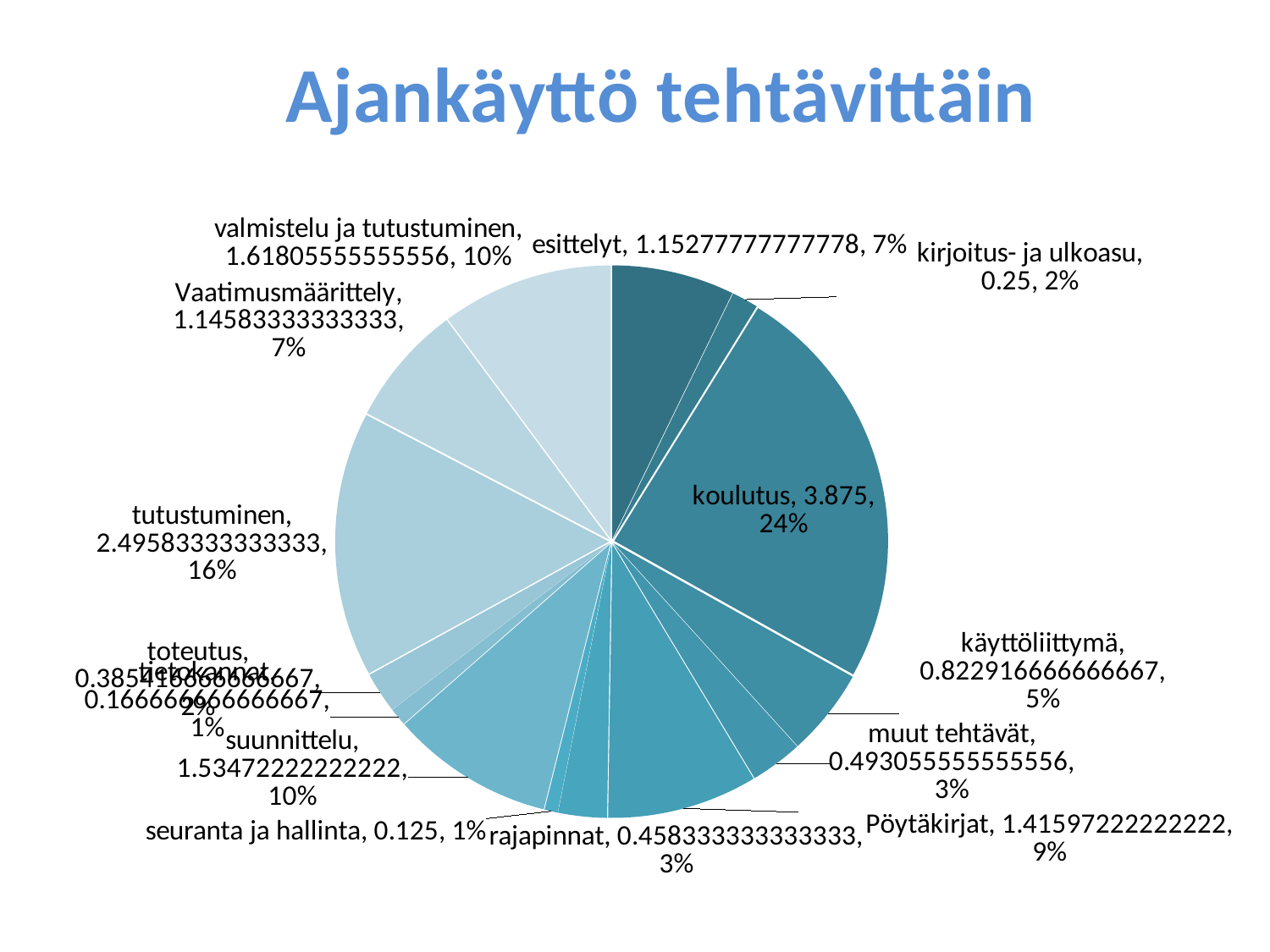
Which category has the smallest slice of the pie? seuranta ja hallinta What share of the pie does tutustuminen represent? 16% Which is larger, the slice for esittelyt or the slice for käyttöliittymä? esittelyt How many categories are shown in the pie chart? 14 What value is shown for kirjoitus- ja ulkoasu? 0.25 What value is shown for suunnittelu? 1.53472222222222 Which category has the largest slice of the pie? koulutus What value is shown for koulutus? 3.875 What percentage is shown for Pöytäkirjat? 9% What is the title of the chart? Ajankäyttö tehtävittäin What kind of chart is shown on the slide? pie chart What is the difference between the values for kirjoitus- ja ulkoasu and seuranta ja hallinta? 0.125